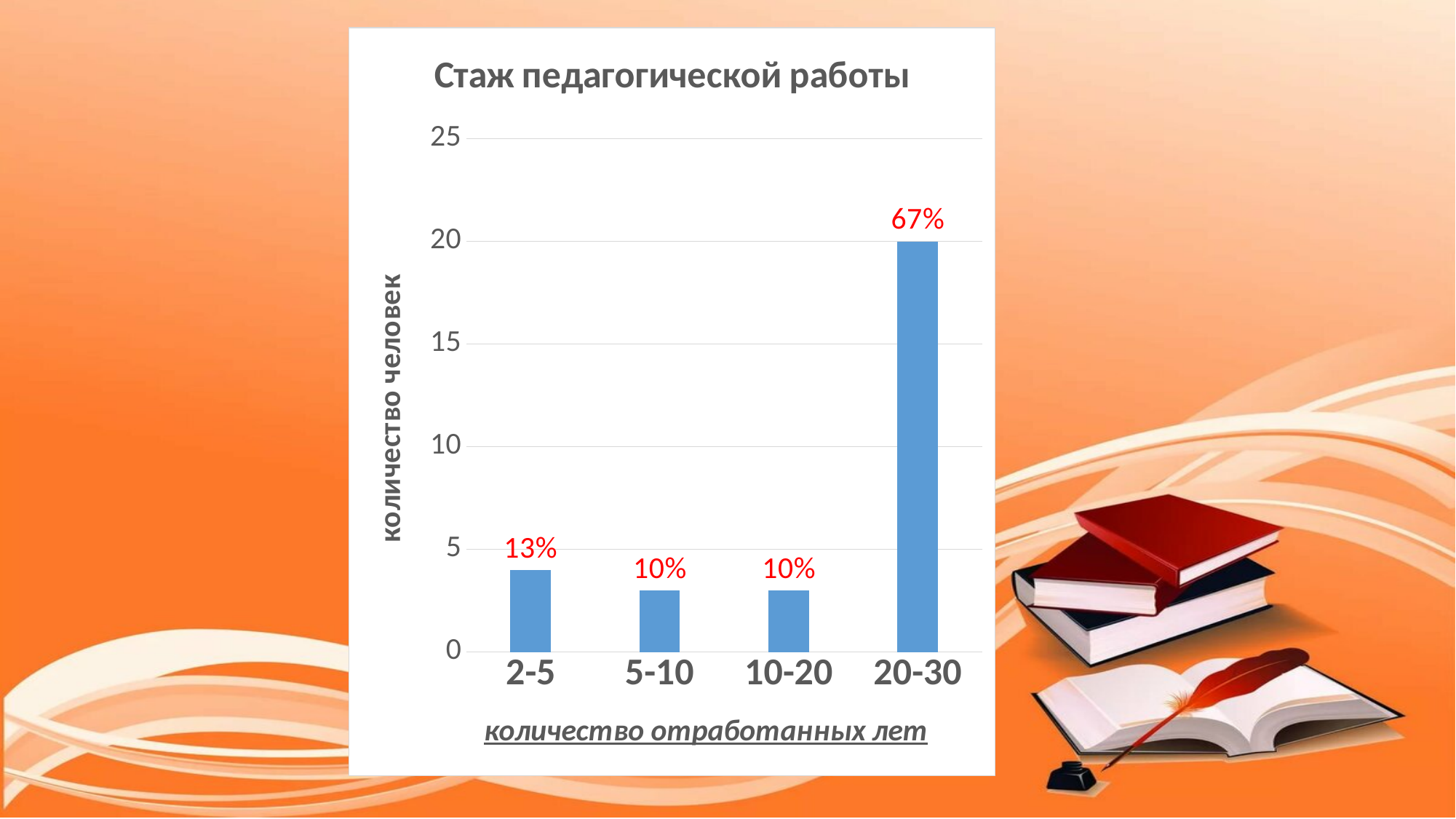
What kind of chart is shown on the slide? bar chart What is the difference between the percentage labels for the 20-30 and 2-5 categories? 54% What is the data label shown on the bar for the 2-5 category? 13% How many people (количество человек) does the bar for the 20-30 category reach on the y axis? 20 What is the data label shown on the bar for the 10-20 category? 10% What is the data label shown on the bar for the 5-10 category? 10% Which category has the highest bar? 20-30 What is the title of the chart? Стаж педагогической работы How many categories are shown on the x axis? 4 What is the data label shown on the bar for the 20-30 category? 67% Which category has a larger value, 2-5 or 5-10? 2-5 Is the value for the 2-5 category greater or less than 5? less